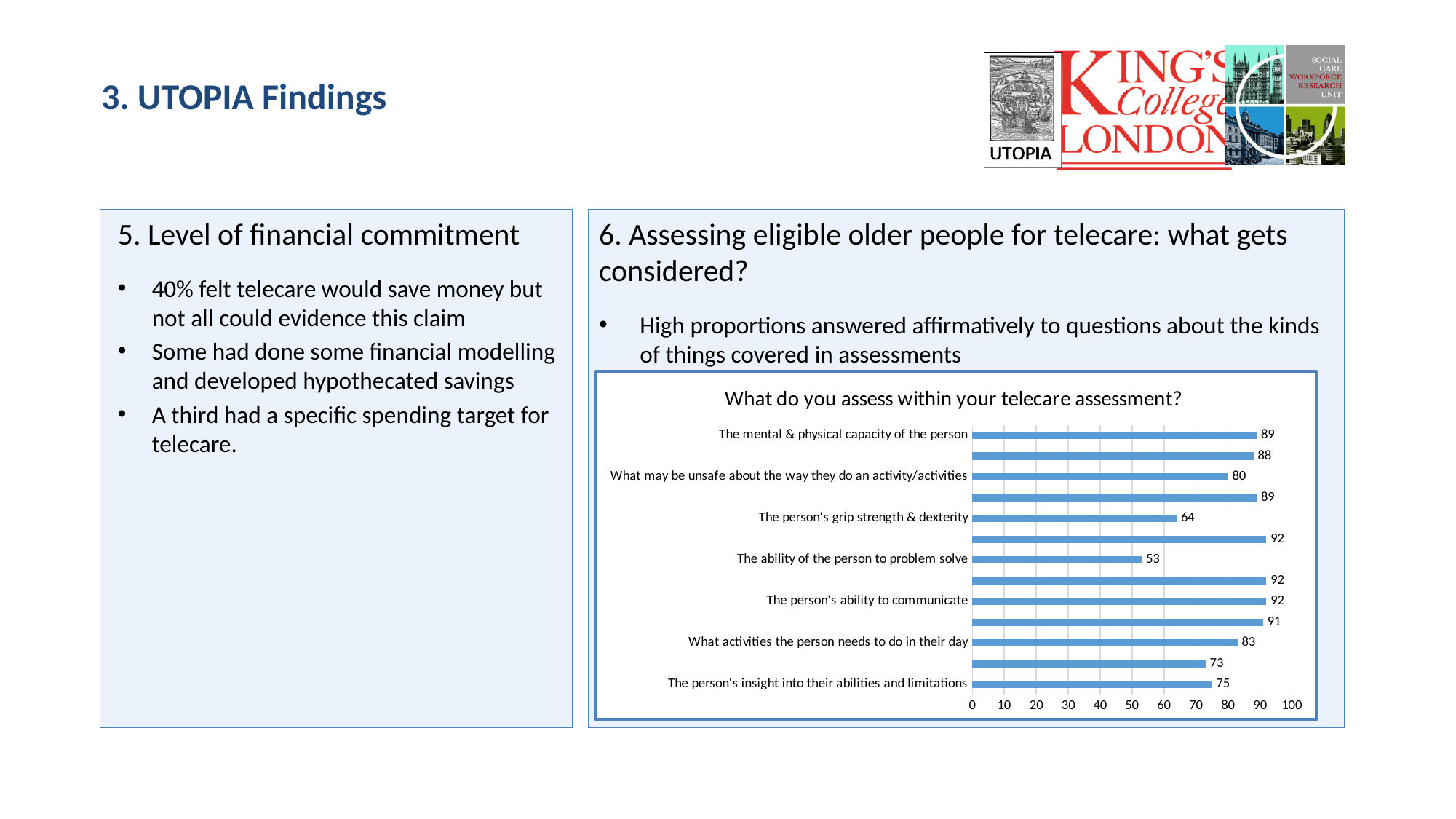
What is the value for 'What may be unsafe about the way they do an activity/activities'? 80 What is the title of the chart? What do you assess within your telecare assessment? What is the difference between the values for 'The person's ability to communicate' and 'The ability of the person to problem solve'? 39 What is the value for 'The person's insight into their abilities and limitations'? 75 Which is larger: the value for 'The mental & physical capacity of the person' or 'The person's grip strength & dexterity'? The mental & physical capacity of the person What is the value for 'The mental & physical capacity of the person'? 89 What is the value for 'The ability of the person to problem solve'? 53 Which labelled category has the lowest value? The ability of the person to problem solve How many bars are plotted in the chart? 13 What kind of chart is shown on the slide? Bar chart Is the value for 'The ability of the person to problem solve' greater or less than 60? less What is the value for 'The person's grip strength & dexterity'? 64